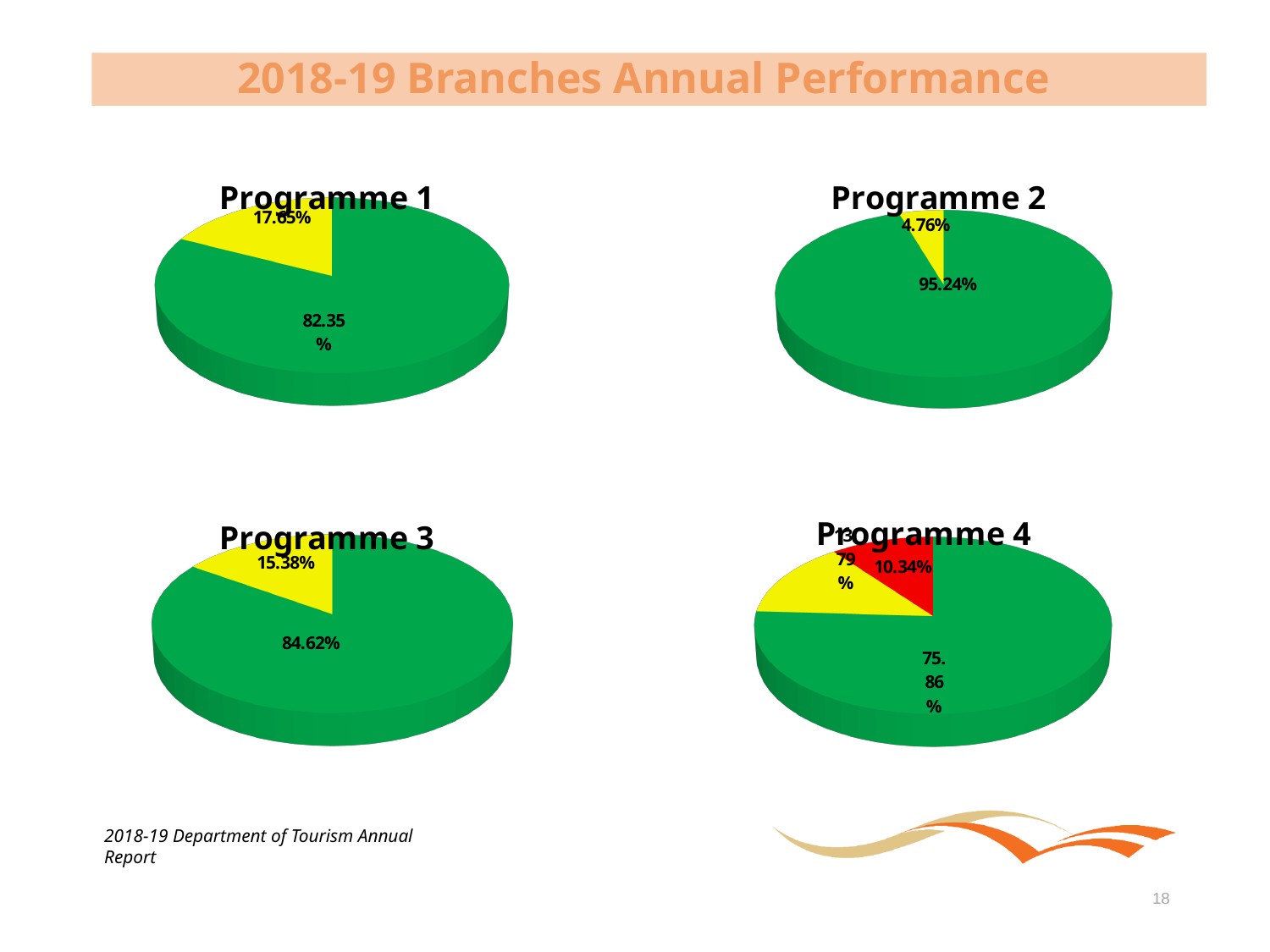
In the Programme 4 chart, what percentage does the red slice represent? 10.34% In the Programme 3 chart, what percentage is shown for the yellow slice? 15.38% Which is larger: the green slice in the Programme 2 chart or the green slice in the Programme 3 chart? Programme 2 In the Programme 3 chart, what percentage is shown for the green slice? 84.62% In the Programme 1 chart, what is the difference between the green slice and the yellow slice? 64.70% In the Programme 1 chart, what percentage does the yellow slice represent? 17.65% In the Programme 1 chart, what percentage does the green slice represent? 82.35% In the Programme 4 chart, what percentage does the green slice represent? 75.86% How many slices does the Programme 4 chart have? 3 In the Programme 2 chart, what is the value of the largest slice? 95.24% What type of chart is used for Programme 1? Pie chart In the Programme 2 chart, what is the value of the smallest slice? 4.76%